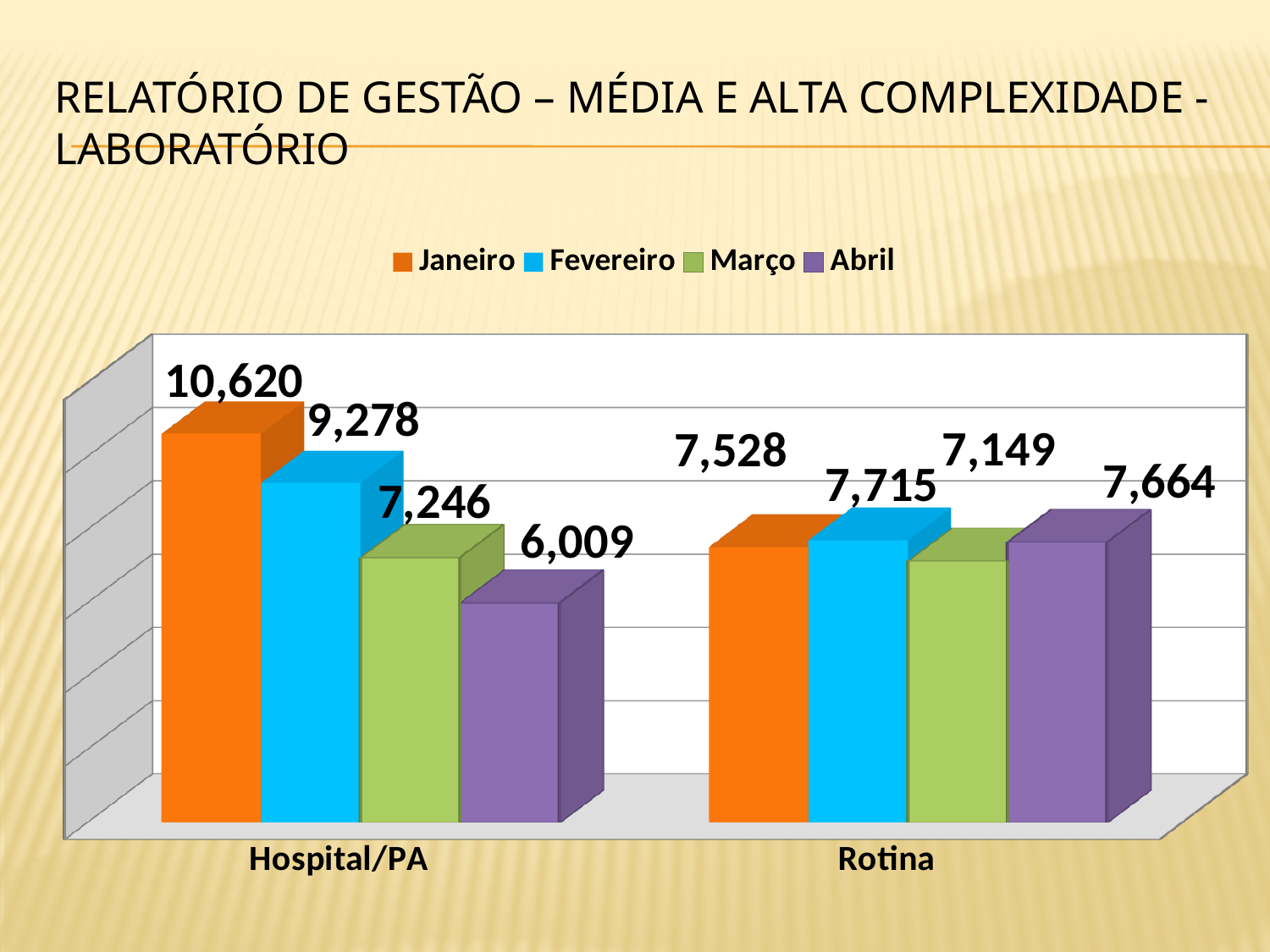
What is the value for Abril in the Rotina category? 7,664 What is the value for Março in the Hospital/PA category? 7,246 What is the difference between the Janeiro and Fevereiro values in the Hospital/PA category? 1,342 What kind of chart is shown on the slide? Bar chart Which month has the lowest value in the Rotina category? Março How many categories are shown on the x axis? 2 What is the value for Janeiro in the Hospital/PA category? 10,620 Which month has the highest value in the Hospital/PA category? Janeiro How many series does the legend list? 4 Do the values for Hospital/PA rise or fall from Janeiro to Abril? Fall Which is larger: the Abril value for Hospital/PA or the Abril value for Rotina? Rotina What is the value for Fevereiro in the Rotina category? 7,715